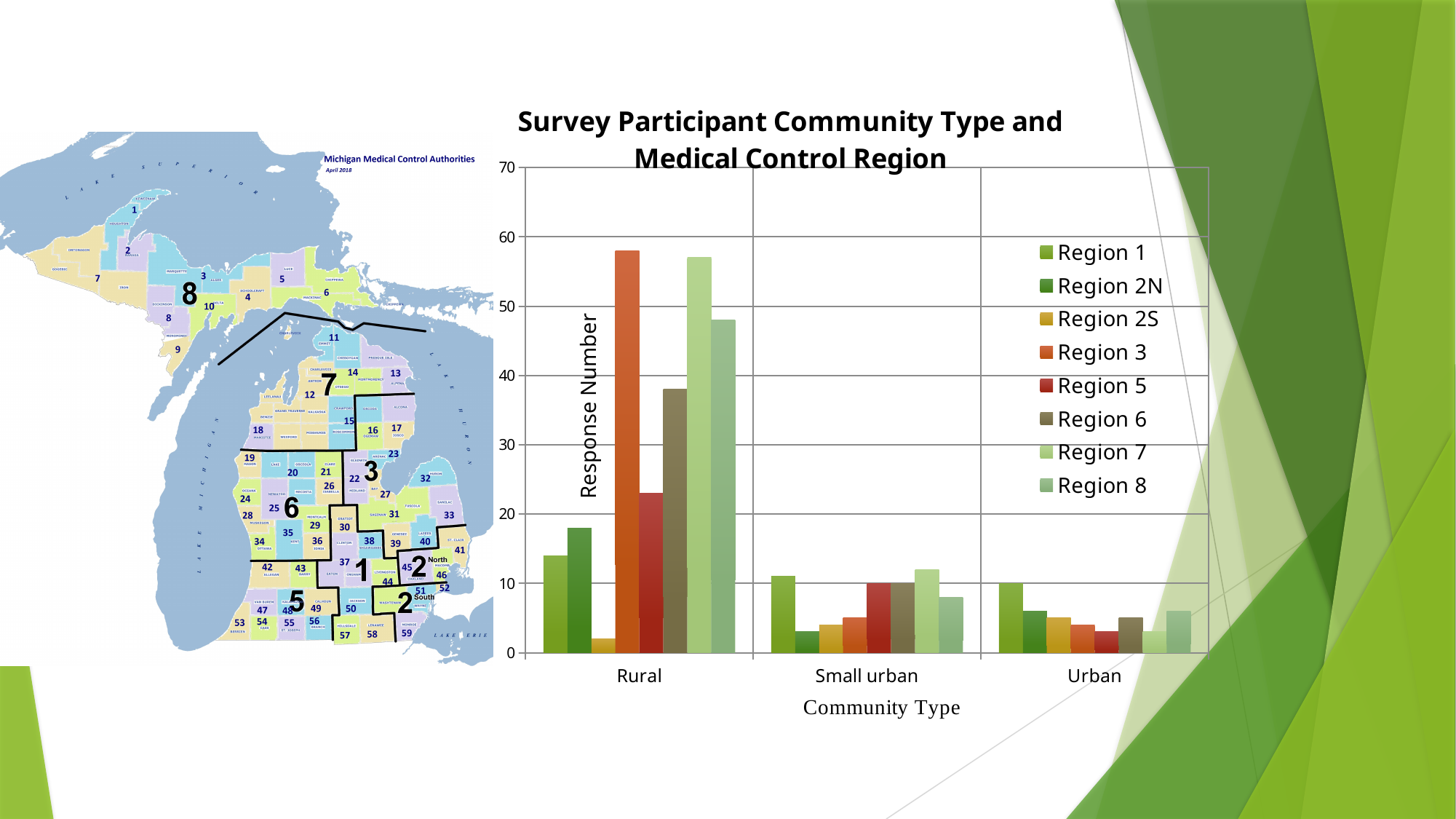
What is the label of the y axis of the chart? Response Number Is the Rural response number for Region 6 greater or less than 40? less Which region has the lowest response number in the Rural category? Region 2S In the Rural category, which is larger: the response number for Region 6 or for Region 5? Region 6 What is the title of the chart? Survey Participant Community Type and Medical Control Region Is the Rural response number for Region 3 greater or less than 50? greater How many community type categories are shown on the x axis of the chart? 3 How many series does the legend of the chart list? 8 Which region has the highest response number in the Urban category? Region 1 Is the Rural response number for Region 8 greater or less than 40? greater In the Rural category, which is larger: the response number for Region 2N or for Region 1? Region 2N What kind of chart is shown on the slide? bar chart